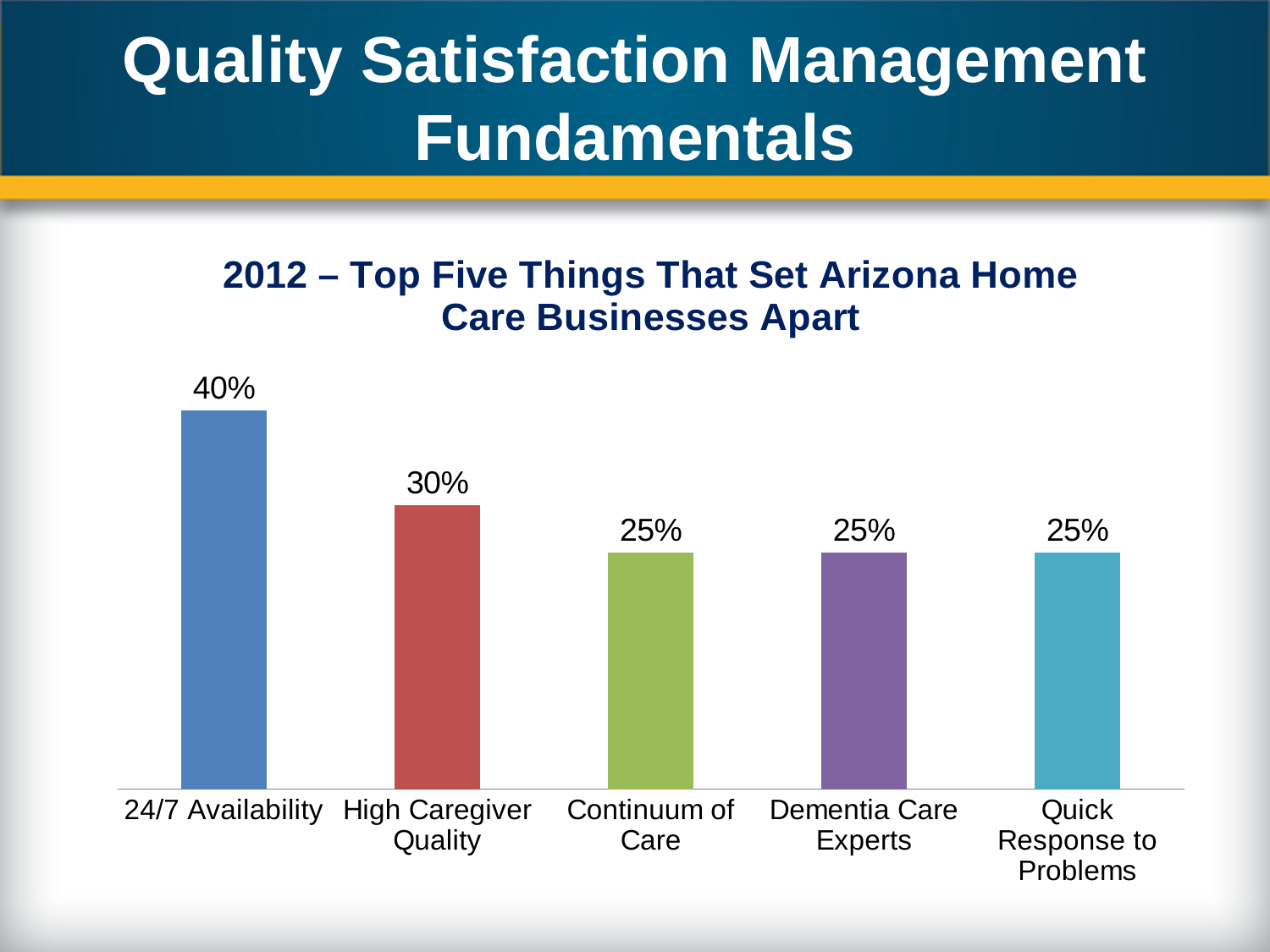
Which is larger, the value for 24/7 Availability or the value for Continuum of Care? 24/7 Availability What is the difference between the values for High Caregiver Quality and Continuum of Care? 5% Which category has the highest value? 24/7 Availability What is the title of the chart? 2012 – Top Five Things That Set Arizona Home Care Businesses Apart What is the difference between the values for 24/7 Availability and High Caregiver Quality? 10% What is the value for Quick Response to Problems? 25% What kind of chart is shown on the slide? Bar chart How many categories are shown in the chart? 5 What is the value for High Caregiver Quality? 30% What is the value for 24/7 Availability? 40% What is the value for Dementia Care Experts? 25% Do the values rise or fall from left to right across the categories? Fall